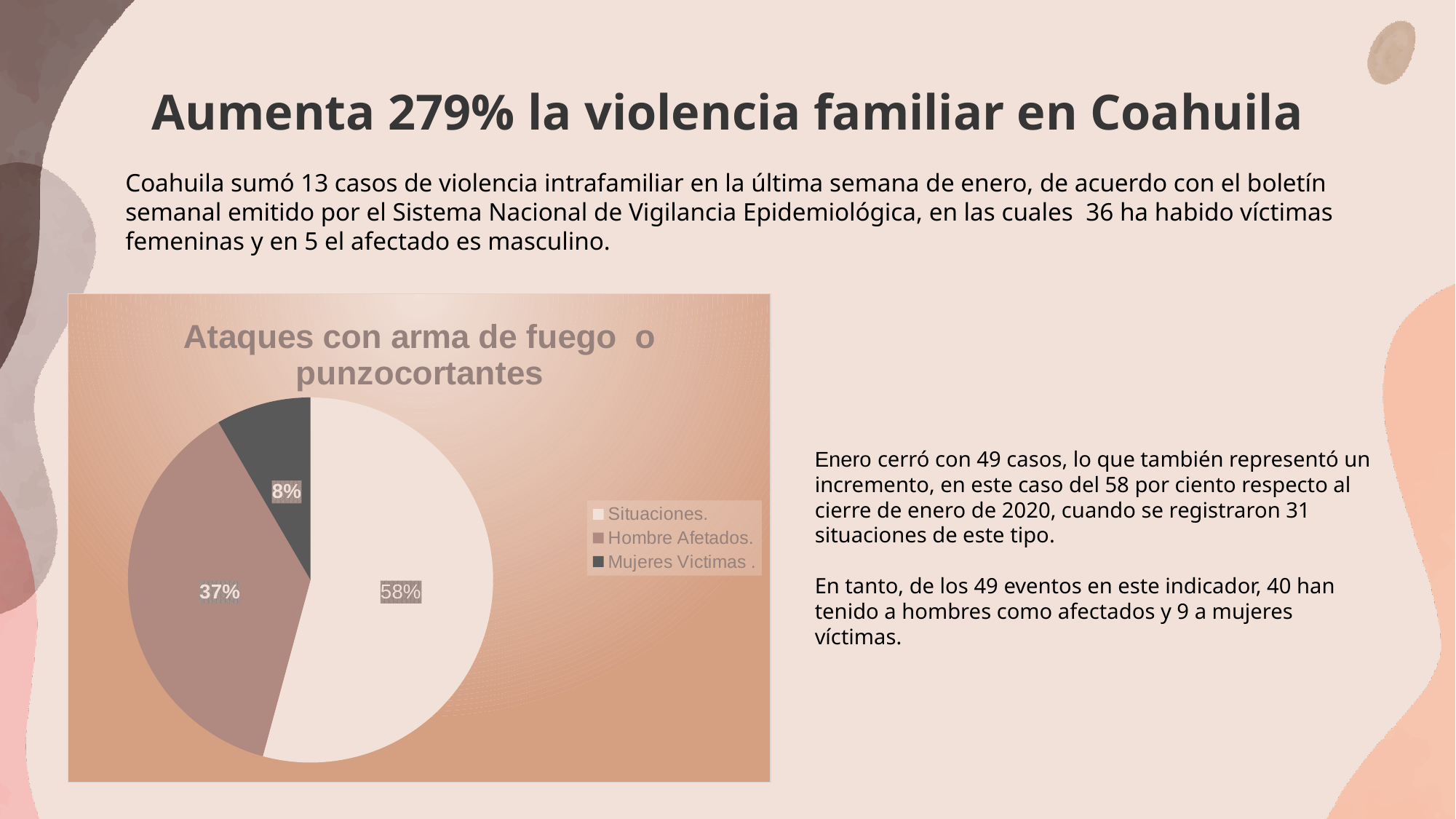
How many slices does the pie chart have? 3 Which slice of the pie is the largest? Situaciones. Which is larger, the 'Hombre Afetados.' slice or the 'Mujeres Victimas .' slice? Hombre Afetados. Which slice of the pie is the smallest? Mujeres Victimas . How many entries does the legend list? 3 What is the title of the chart? Ataques con arma de fuego o punzocortantes What share of the pie does the 'Situaciones.' slice represent? 58% What share of the pie does the 'Hombre Afetados.' slice represent? 37% What is the difference in percentage points between the 'Hombre Afetados.' slice and the 'Mujeres Victimas .' slice? 29% What share of the pie does the 'Mujeres Victimas .' slice represent? 8% What kind of chart is shown on the slide? Pie chart What is the difference in percentage points between the 'Situaciones.' slice and the 'Hombre Afetados.' slice? 21%